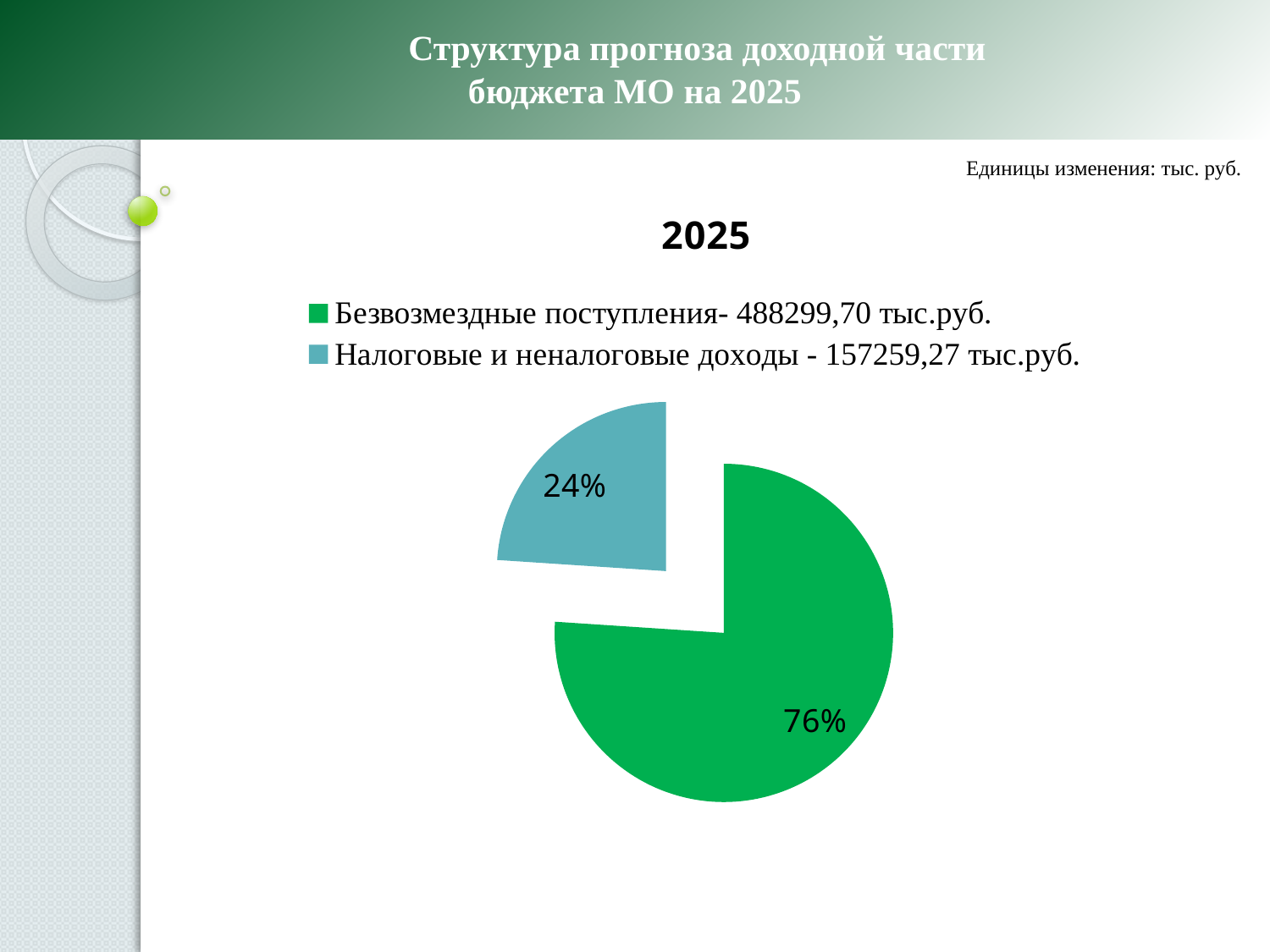
How many slices does the pie chart have? 2 What is the value for Безвозмездные поступления according to the legend? 488299,70 тыс.руб. By how many percentage points does the share of Безвозмездные поступления exceed that of Налоговые и неналоговые доходы? 52 What kind of chart is shown on the slide? pie chart Which slice is the largest? Безвозмездные поступления Which colour represents Налоговые и неналоговые доходы in the chart? teal (blue-green) How many entries does the legend list? 2 Which slice is the smallest? Налоговые и неналоговые доходы What is the title of the chart? 2025 What share of the pie is Налоговые и неналоговые доходы? 24% What share of the pie is Безвозмездные поступления? 76% What is the value for Налоговые и неналоговые доходы according to the legend? 157259,27 тыс.руб.